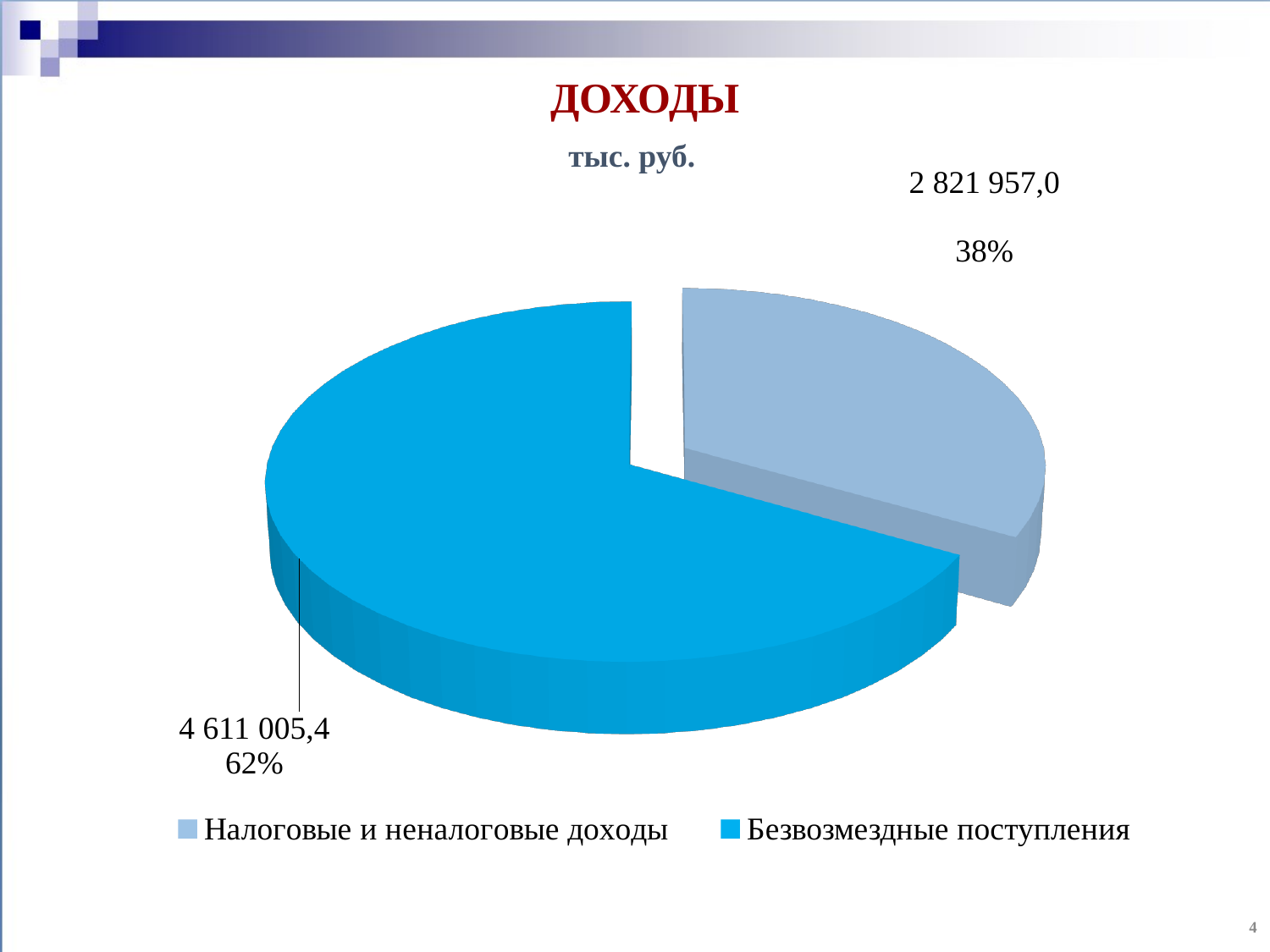
What is the difference between the values for Безвозмездные поступления and Налоговые и неналоговые доходы? 1 789 048,4 What unit is stated under the chart title? тыс. руб. Which category has the smallest slice of the pie? Налоговые и неналоговые доходы What is the value for Безвозмездные поступления? 4 611 005,4 Which category has the largest slice of the pie? Безвозмездные поступления How many slices does the pie chart have? 2 Which is larger: Безвозмездные поступления or Налоговые и неналоговые доходы? Безвозмездные поступления What share of the pie does Налоговые и неналоговые доходы represent? 38% What is the title of the chart? ДОХОДЫ What is the value for Налоговые и неналоговые доходы? 2 821 957,0 What kind of chart is shown on the slide? Pie chart What share of the pie does Безвозмездные поступления represent? 62%